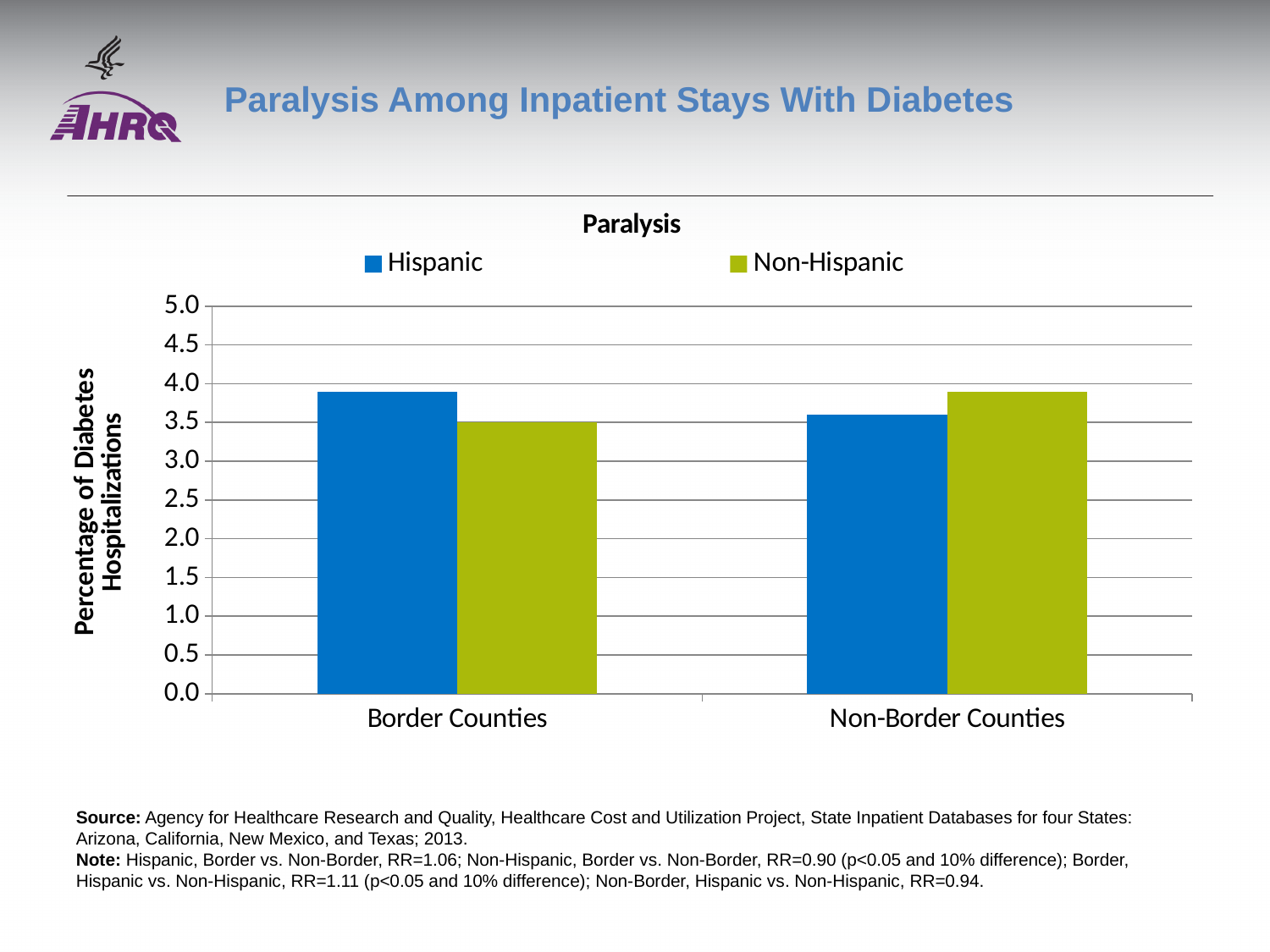
What are the two series named in the legend? Hispanic and Non-Hispanic In Non-Border Counties, which is larger: the Hispanic value or the Non-Hispanic value? Non-Hispanic How many series does the legend list? 2 Is the Hispanic value for Border Counties greater or less than 3.5? greater What is the y-axis label of the chart? Percentage of Diabetes Hospitalizations Is the Non-Hispanic value for Border Counties greater or less than 4.0? less For the Hispanic series, which is larger: Border Counties or Non-Border Counties? Border Counties For the Non-Hispanic series, which is larger: Border Counties or Non-Border Counties? Non-Border Counties How many categories are shown on the x axis? 2 What kind of chart is shown on the slide? bar chart Is the Non-Hispanic value for Non-Border Counties greater or less than 3.5? greater